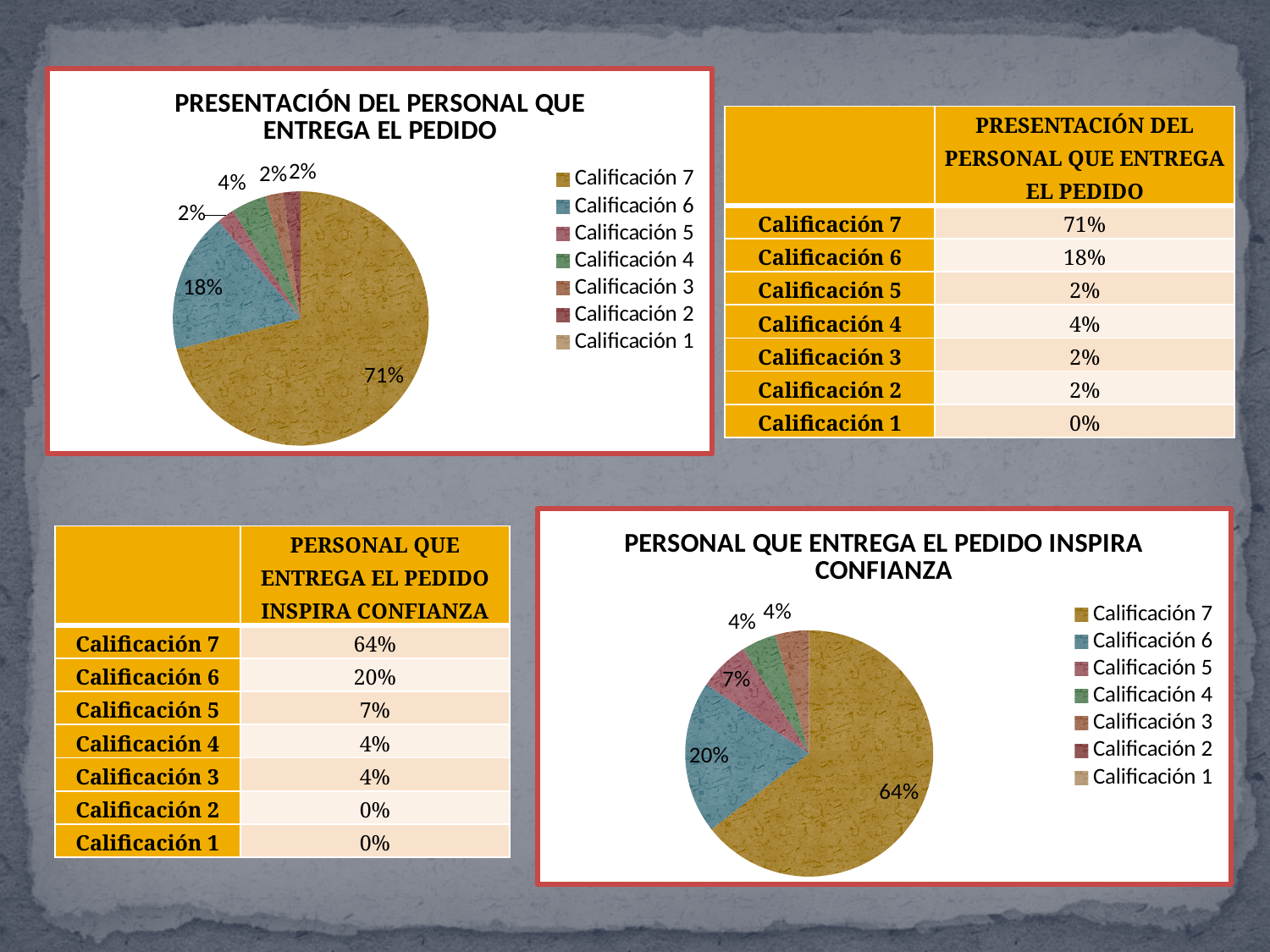
In the pie chart titled 'PRESENTACIÓN DEL PERSONAL QUE ENTREGA EL PEDIDO', what is the value for Calificación 6? 18% In the pie chart titled 'PRESENTACIÓN DEL PERSONAL QUE ENTREGA EL PEDIDO', what is the difference between Calificación 7 and Calificación 6? 53% In the pie chart titled 'PRESENTACIÓN DEL PERSONAL QUE ENTREGA EL PEDIDO', which category has the largest slice? Calificación 7 What kind of chart is the chart titled 'PERSONAL QUE ENTREGA EL PEDIDO INSPIRA CONFIANZA'? Pie chart In the pie chart titled 'PERSONAL QUE ENTREGA EL PEDIDO INSPIRA CONFIANZA', which is larger, Calificación 6 or Calificación 5? Calificación 6 Which chart has the larger share for Calificación 7, 'PRESENTACIÓN DEL PERSONAL QUE ENTREGA EL PEDIDO' or 'PERSONAL QUE ENTREGA EL PEDIDO INSPIRA CONFIANZA'? PRESENTACIÓN DEL PERSONAL QUE ENTREGA EL PEDIDO In the pie chart titled 'PRESENTACIÓN DEL PERSONAL QUE ENTREGA EL PEDIDO', what share does Calificación 7 have? 71% In the pie chart titled 'PERSONAL QUE ENTREGA EL PEDIDO INSPIRA CONFIANZA', what share does Calificación 7 have? 64% How many entries does the legend of the pie chart titled 'PRESENTACIÓN DEL PERSONAL QUE ENTREGA EL PEDIDO' list? 7 In the pie chart titled 'PERSONAL QUE ENTREGA EL PEDIDO INSPIRA CONFIANZA', what is the difference between Calificación 6 and Calificación 5? 13% In the pie chart titled 'PERSONAL QUE ENTREGA EL PEDIDO INSPIRA CONFIANZA', what is the value for Calificación 5? 7% In the pie chart titled 'PERSONAL QUE ENTREGA EL PEDIDO INSPIRA CONFIANZA', what colour is the slice for Calificación 6? Blue